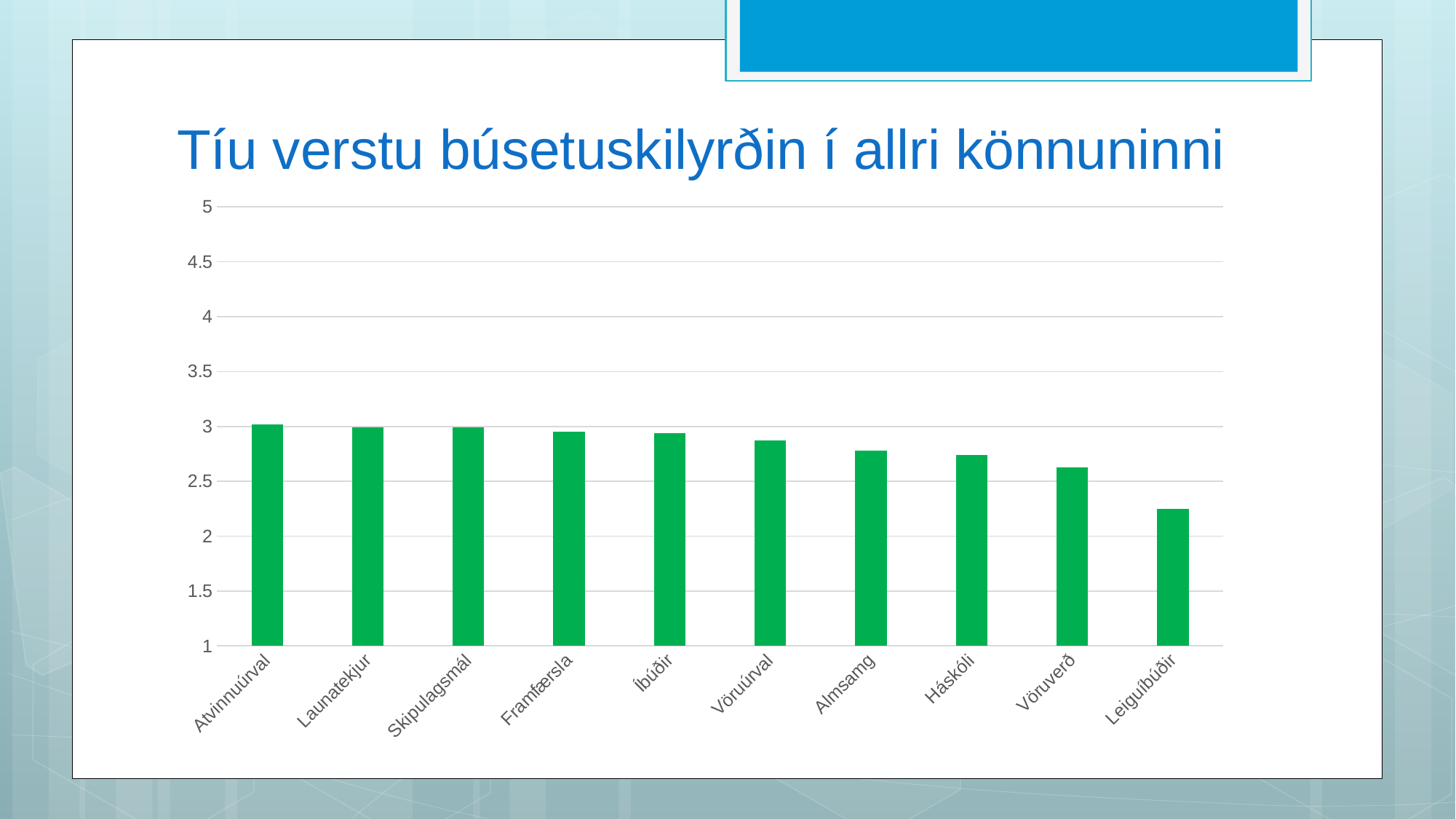
Do the values rise or fall from left to right along the x axis? fall What kind of chart is shown on the slide? bar chart Is the value for Almsamg greater or less than 2.5? greater Which has the larger value, Vöruverð or Leiguíbúðir? Vöruverð Is the value for Vöruverð greater or less than 2.5? greater Which category has the lowest value in the chart? Leiguíbúðir Is the value for Vöruúrval greater or less than 3? less Which has the larger value, Háskóli or Vöruverð? Háskóli How many categories are plotted in the chart? 10 What is the title of the slide above the chart? Tíu verstu búsetuskilyrðin í allri könnuninni